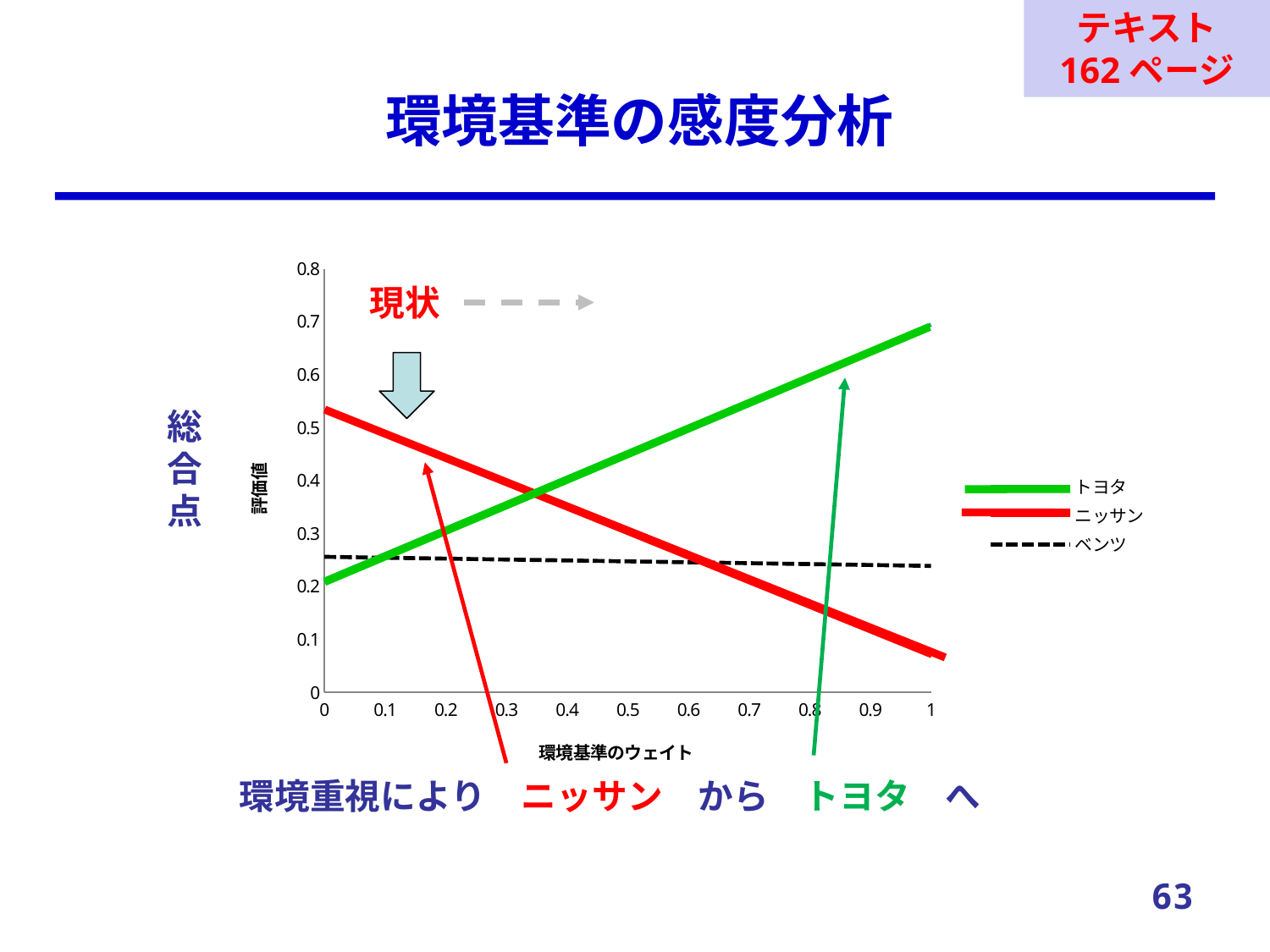
What is the title of the x axis of the chart? 環境基準のウェイト At 環境基準のウェイト = 1, which series has the highest value? トヨタ What kind of chart is shown on the slide? line chart At 環境基準のウェイト = 0, which series has the lowest value? トヨタ Is the value for ニッサン at 環境基準のウェイト = 1 greater or less than 0.2? less Does the value for ニッサン rise or fall as 環境基準のウェイト increases from 0 to 1? fall At 環境基準のウェイト = 0, which is larger, the value for ニッサン or the value for トヨタ? ニッサン Is the value for ベンツ at 環境基準のウェイト = 0.5 greater or less than 0.3? less How many series does the legend list? 3 Is the value for トヨタ at 環境基準のウェイト = 0 greater or less than 0.3? less Does the value for トヨタ rise or fall as 環境基準のウェイト increases from 0 to 1? rise